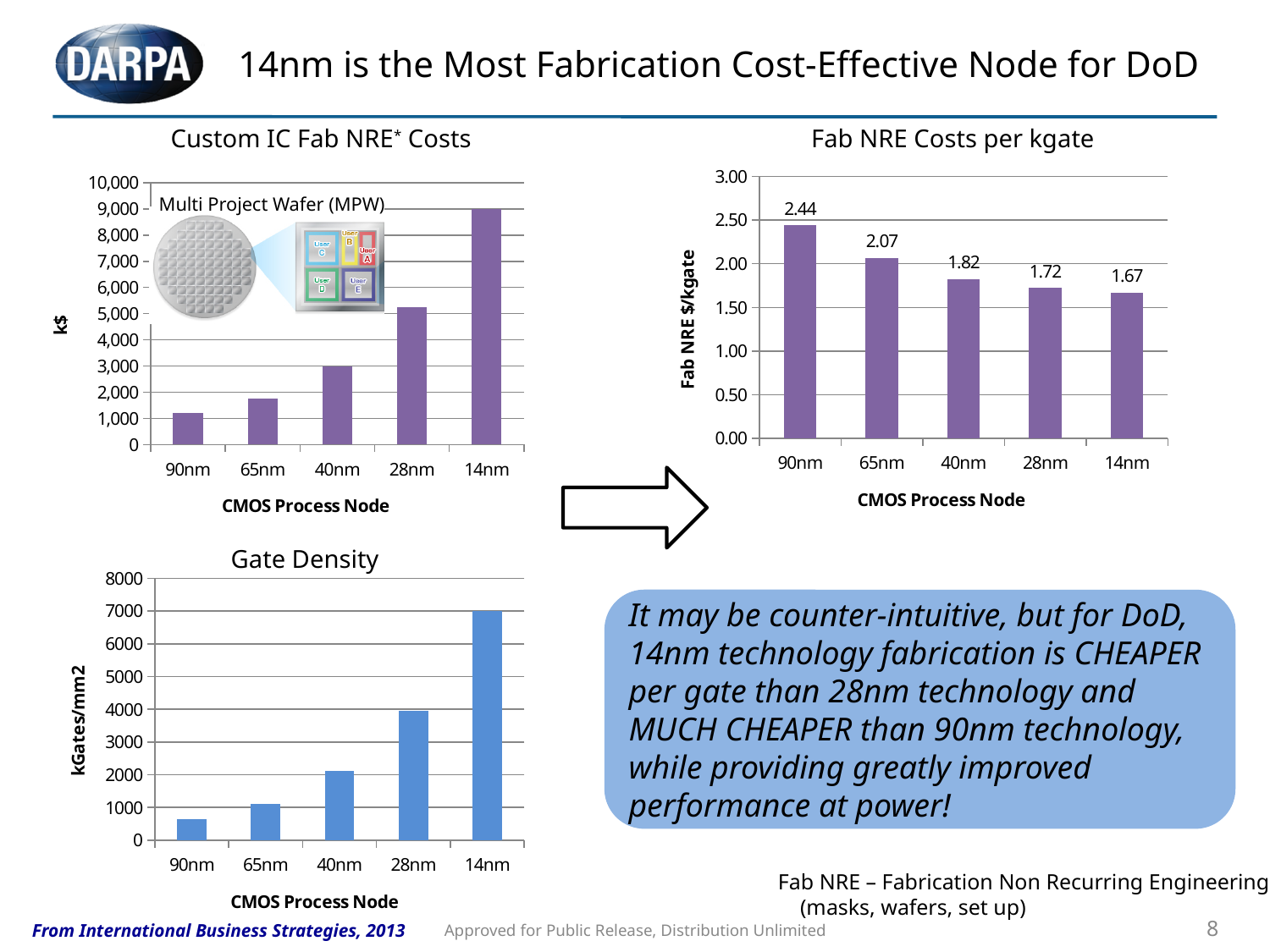
In the 'Fab NRE Costs per kgate' chart, which process node has the highest cost per kgate? 90nm In the 'Fab NRE Costs per kgate' chart, what is the value for 40nm? 1.82 In the 'Fab NRE Costs per kgate' chart, what is the value for 90nm? 2.44 How many process nodes are shown on the x axis of the 'Gate Density' chart? 5 What kind of chart is the 'Gate Density' chart? bar chart In the 'Custom IC Fab NRE* Costs' chart, which process node has the highest cost? 14nm In the 'Fab NRE Costs per kgate' chart, which process node has the lowest cost per kgate? 14nm In the 'Custom IC Fab NRE* Costs' chart, is the value for 28nm greater or less than 4,000? greater In the 'Fab NRE Costs per kgate' chart, what is the value for 14nm? 1.67 In the 'Gate Density' chart, is the value for 40nm greater or less than 3000? less In the 'Fab NRE Costs per kgate' chart, what is the difference between the 90nm and 14nm values? 0.77 In the 'Fab NRE Costs per kgate' chart, do the values rise or fall from 90nm to 14nm? fall